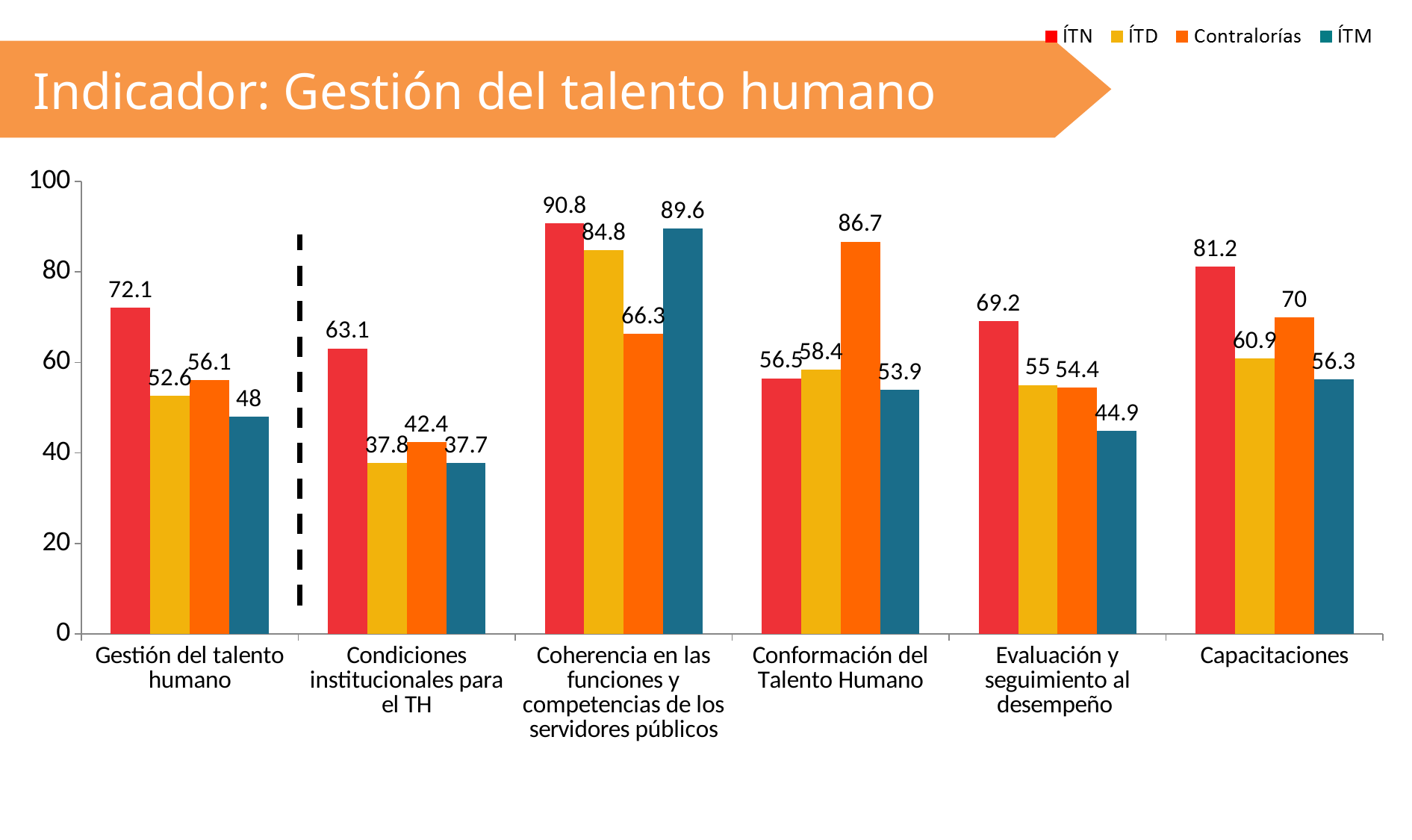
What is the difference between the ÍTN and ÍTM values for Gestión del talento humano? 24.1 What is the ÍTN value for Gestión del talento humano? 72.1 Which is larger for Evaluación y seguimiento al desempeño: the ÍTN value or the Contralorías value? ÍTN How many series does the legend list? 4 Which category has the highest ÍTN value? Coherencia en las funciones y competencias de los servidores públicos What is the Contralorías value for Conformación del Talento Humano? 86.7 Which category has the lowest ÍTM value? Condiciones institucionales para el TH How many categories are shown on the x axis? 6 What is the ÍTD value for Capacitaciones? 60.9 What is the ÍTM value for Condiciones institucionales para el TH? 37.7 What kind of chart is shown on the slide? Bar chart What is the title of the slide? Indicador: Gestión del talento humano